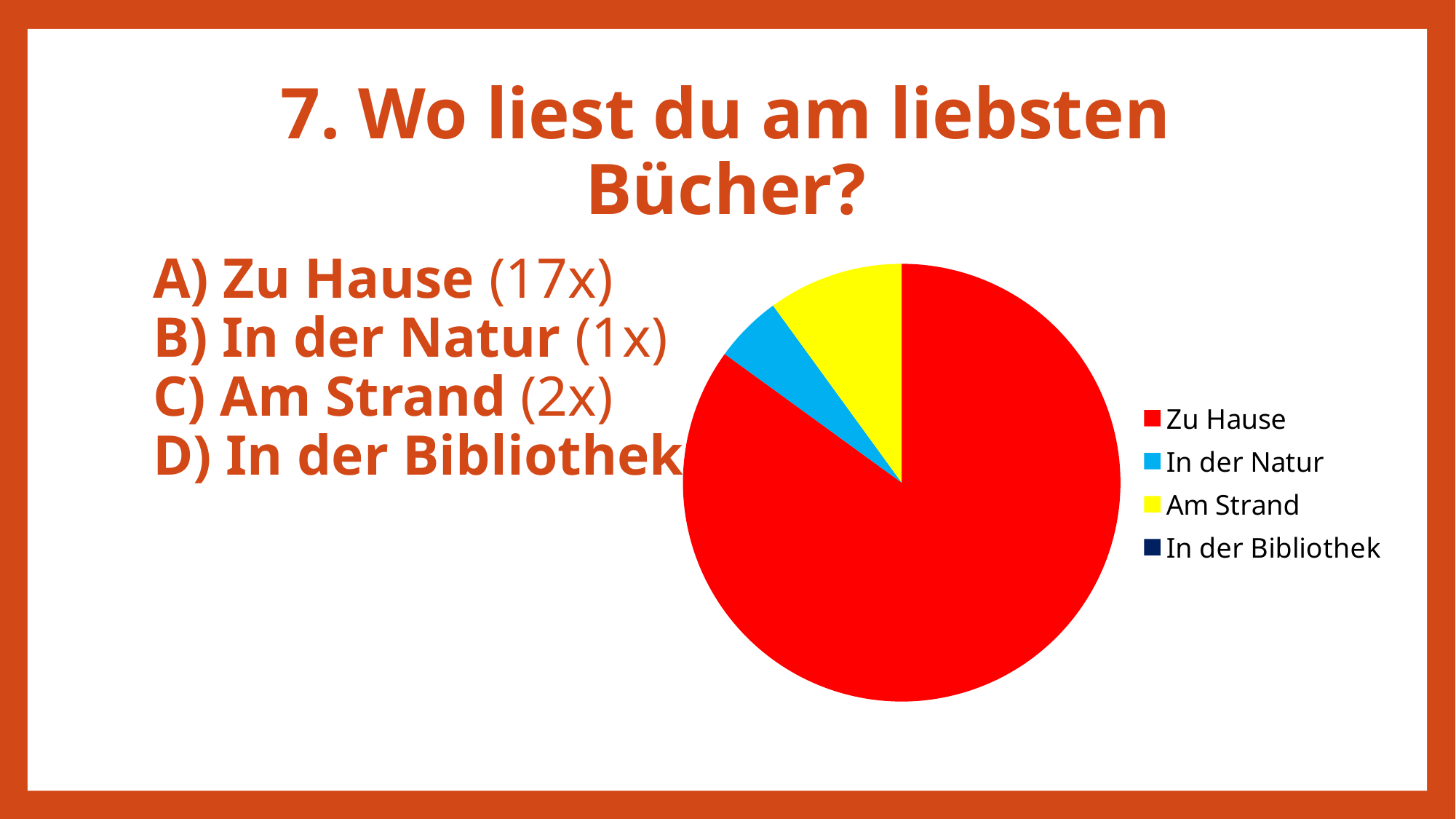
Which slice is larger, 'Zu Hause' or 'Am Strand'? Zu Hause Which category has the largest slice of the pie? Zu Hause Which category is shown in yellow in the pie chart? Am Strand How many categories does the legend list? 4 What is the difference between the counts for 'Am Strand' and 'In der Natur'? 1 How many times was 'In der Natur' chosen, according to the slide? 1x What kind of chart is shown on the slide? pie chart What colour is the 'Zu Hause' slice in the pie chart? red Which slice is larger, 'In der Natur' or 'Am Strand'? Am Strand What is the difference between the counts for 'Zu Hause' and 'Am Strand'? 15 How many times was 'Zu Hause' chosen, according to the slide? 17x How many times was 'Am Strand' chosen, according to the slide? 2x